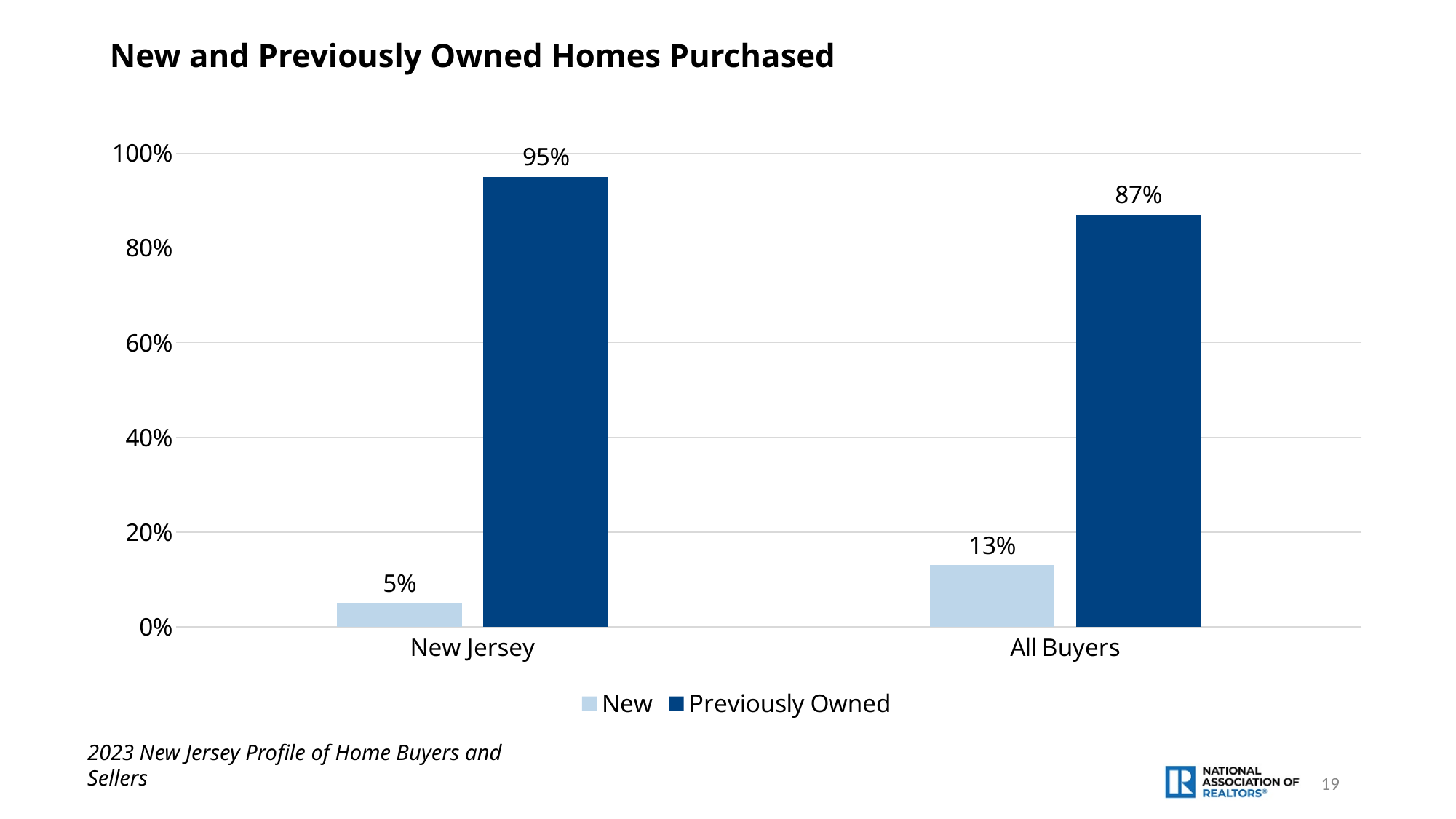
What kind of chart is shown on the slide? Bar chart Which category has the lower share of new homes purchased? New Jersey What is the difference between the Previously Owned share for New Jersey and for All Buyers? 8% How many series does the legend list? 2 What percentage of New Jersey buyers purchased a previously owned home? 95% What is the title of the chart? New and Previously Owned Homes Purchased What is the difference between the New share for All Buyers and for New Jersey? 8% What percentage of All Buyers purchased a new home? 13% Which category has the higher share of previously owned homes purchased, New Jersey or All Buyers? New Jersey How many categories are shown on the x axis? 2 What percentage of All Buyers purchased a previously owned home? 87% What percentage of New Jersey buyers purchased a new home? 5%